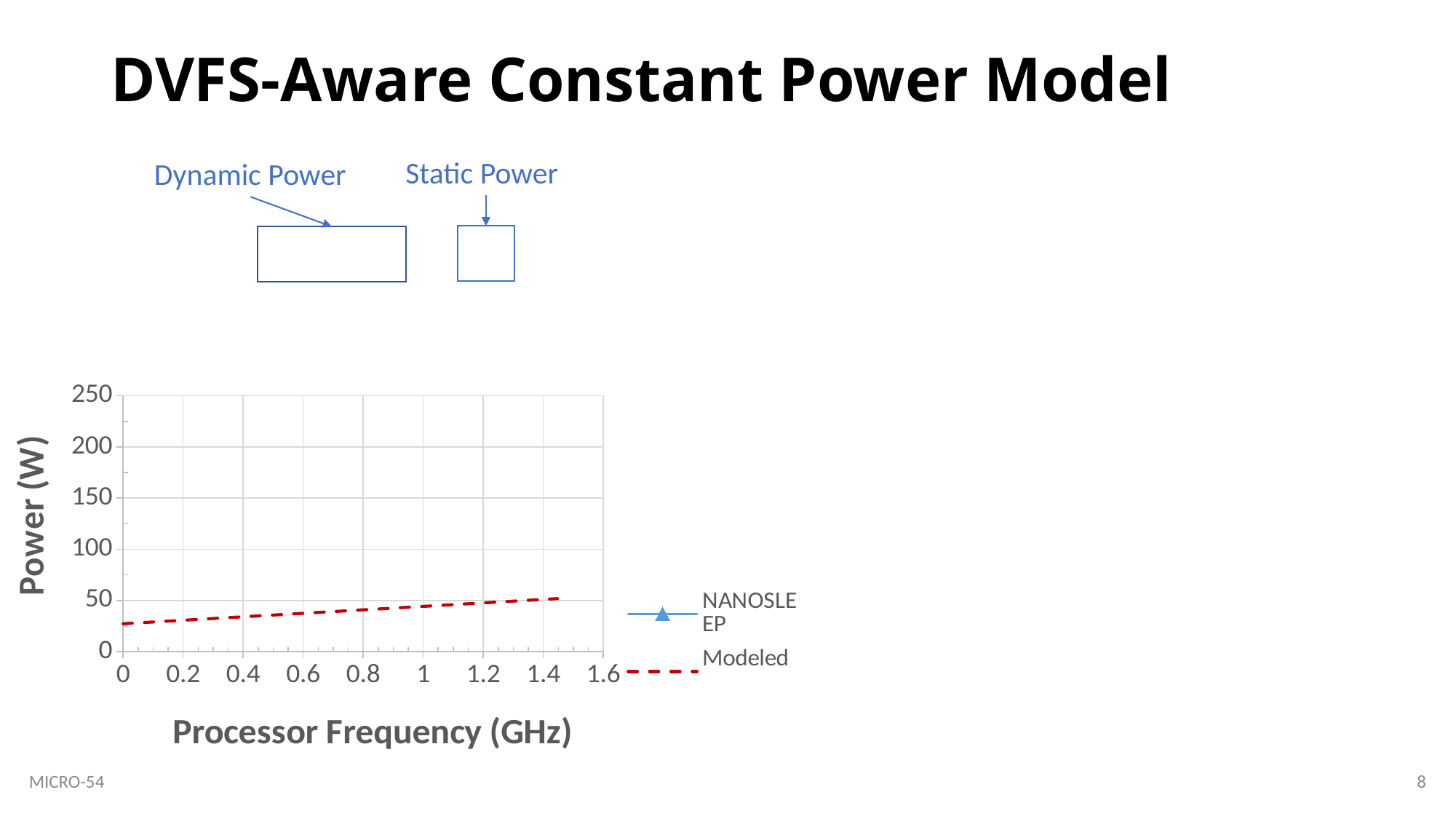
What is the label of the x axis of the chart? Processor Frequency (GHz) Does the Modeled line rise or fall as processor frequency increases? rises Which series in the legend is drawn as a dashed red line? Modeled Is the Modeled power value at 0.8 GHz greater or less than 50? less What kind of chart is shown on the slide? line chart Is the Modeled power value at 0.2 GHz greater or less than 0? greater How many series does the chart legend list? 2 Is the Modeled power value at 0 GHz greater or less than 50? less What is the label of the y axis of the chart? Power (W)